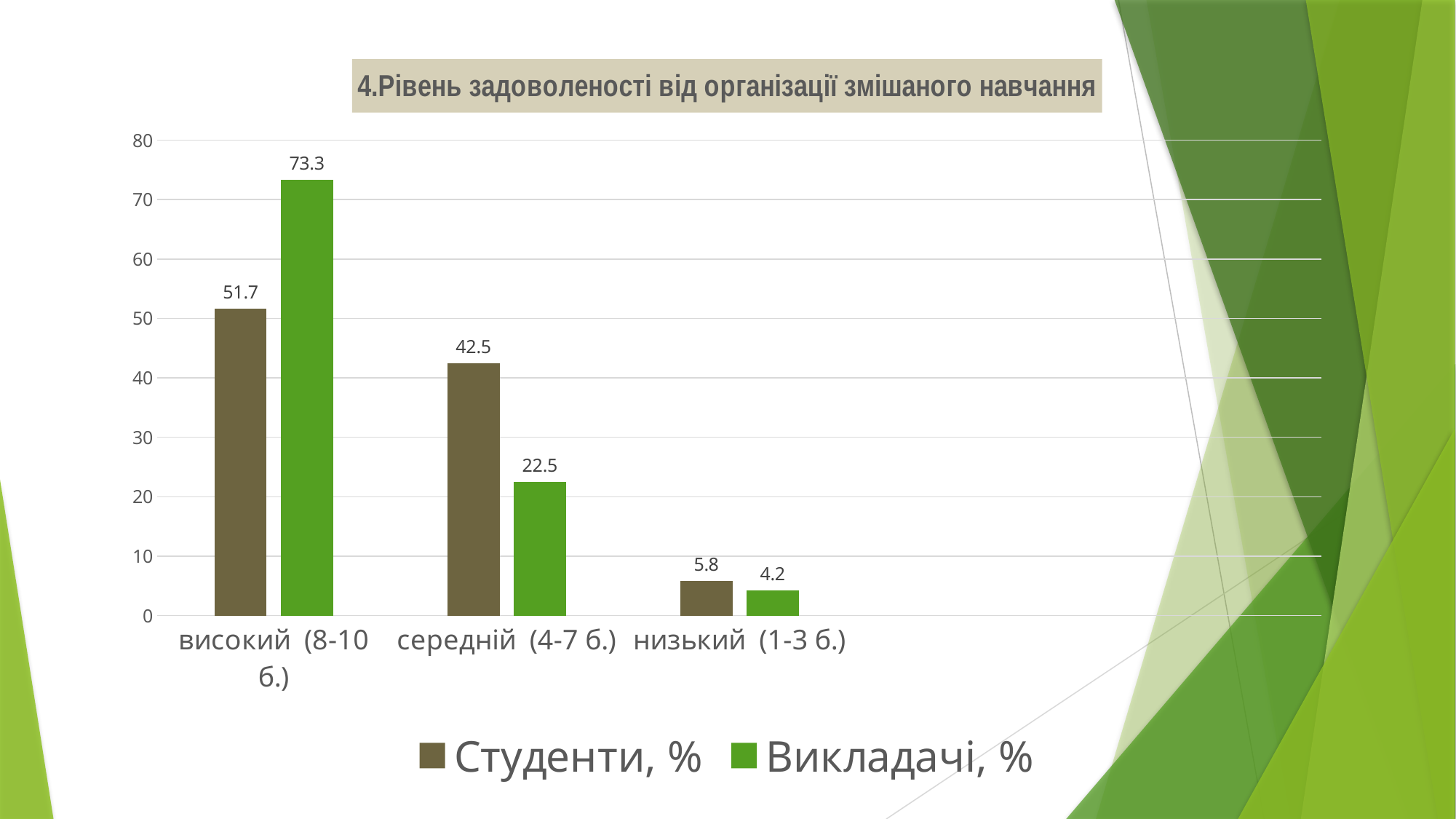
What is the value for Викладачі, % in the низький (1-3 б.) category? 4.2 What is the value for Студенти, % in the середній (4-7 б.) category? 42.5 What kind of chart is shown on the slide? bar chart What is the value for Студенти, % in the високий (8-10 б.) category? 51.7 Which category has the highest value for Викладачі, %? високий (8-10 б.) What is the value for Викладачі, % in the високий (8-10 б.) category? 73.3 How many categories are shown on the x axis? 3 In the середній (4-7 б.) category, which series has the larger value, Студенти, % or Викладачі, %? Студенти, % How many series does the legend list? 2 Which category has the lowest value for Студенти, %? низький (1-3 б.) What is the title of the chart? 4.Рівень задоволеності від організації змішаного навчання What is the difference between the Викладачі, % and Студенти, % values in the високий (8-10 б.) category? 21.6